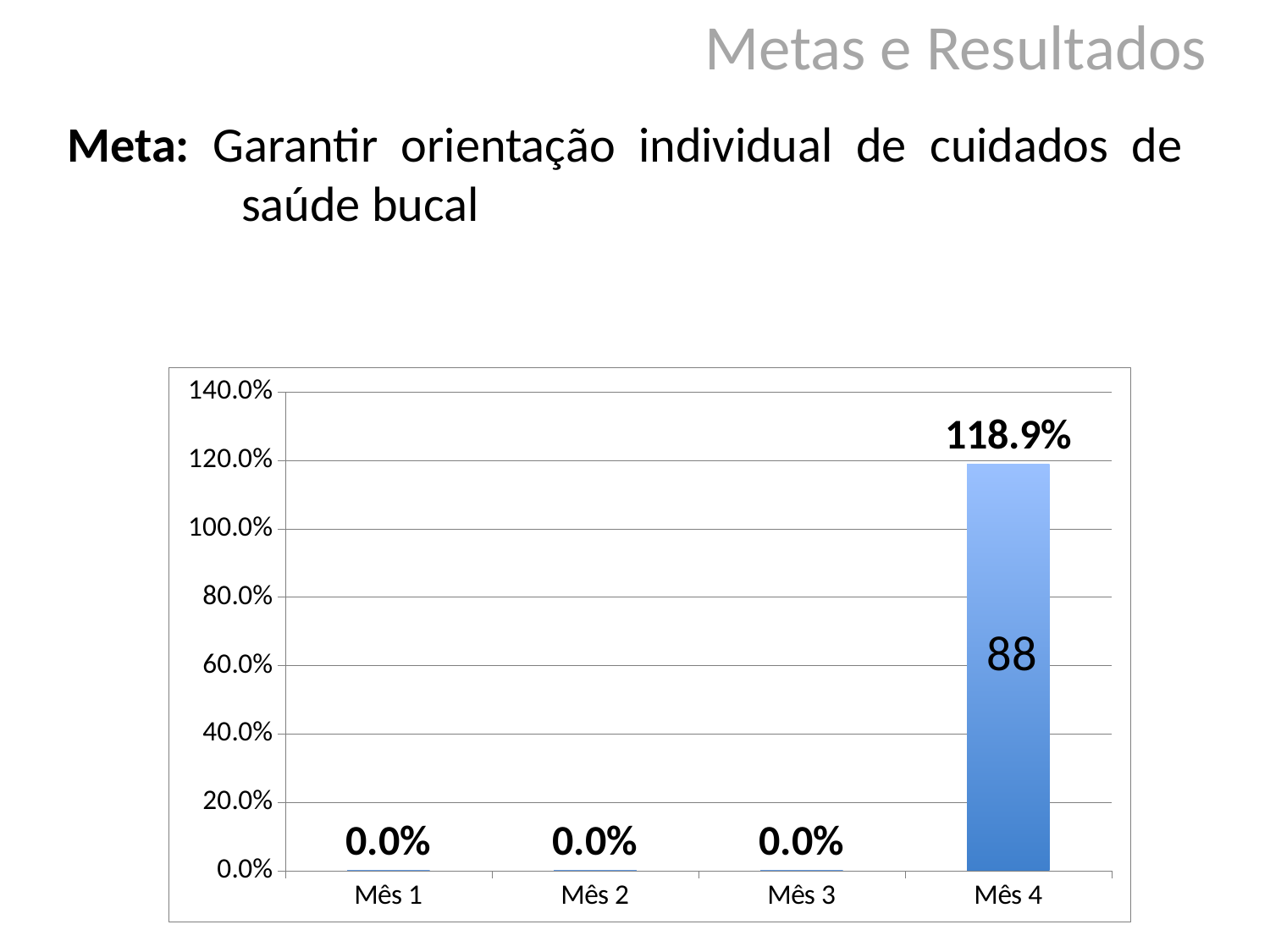
How many months are shown on the x axis? 4 Is the value for Mês 4 greater or less than 100.0%? greater What is the highest value shown on the y axis? 140.0% What number is printed inside the bar for Mês 4? 88 What kind of chart is shown on the slide? bar chart What is the value for Mês 4? 118.9% What is the difference between the values for Mês 4 and Mês 2? 118.9% What is the value for Mês 3? 0.0% Which is larger, the value for Mês 4 or the value for Mês 1? Mês 4 What is the value for Mês 1? 0.0% How many months have a value of 0.0%? 3 Which month has the highest value? Mês 4